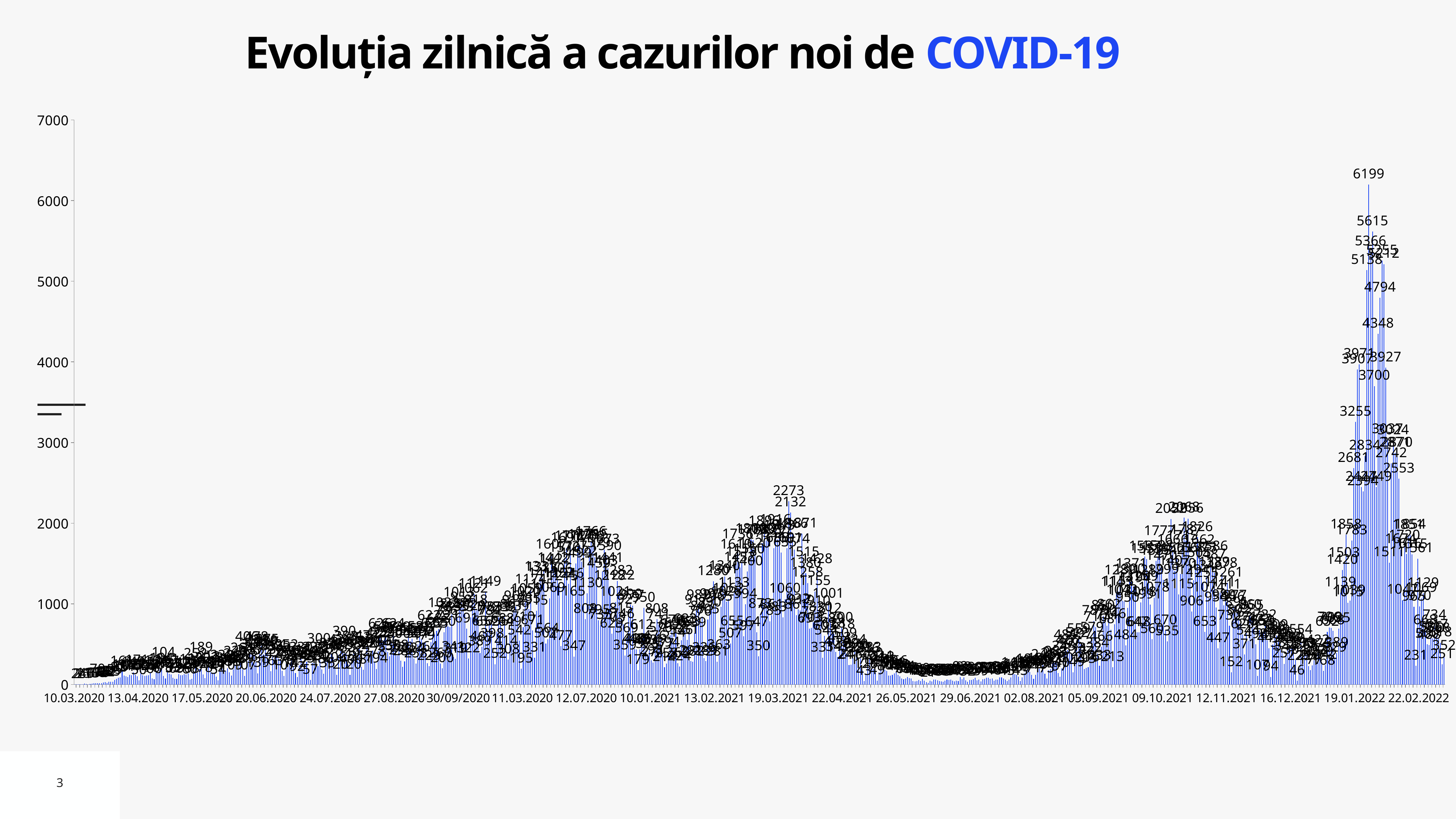
What is the highest labeled value in the wave around 19.03.2021? 2273 Do the daily values generally rise or fall between 09.10.2021 and 16.12.2021? fall What is the last date shown on the horizontal axis? 22.02.2022 Which is larger: the peak of the wave around 19.03.2021 (2273) or the peak of the wave in early 2022 (6199)? the early 2022 peak (6199) Are the daily values around 29.06.2021 greater or less than 1000? less What is the highest value shown on the vertical axis? 7000 What is the title of the chart? Evoluția zilnică a cazurilor noi de COVID-19 Is the highest bar on the chart greater or less than 6000? greater What is the highest daily value labeled on the chart? 6199 What kind of chart is shown on the slide? bar chart What is the first date shown on the horizontal axis? 10.03.2020 What is the difference between the two highest labeled values, 6199 and 5615? 584